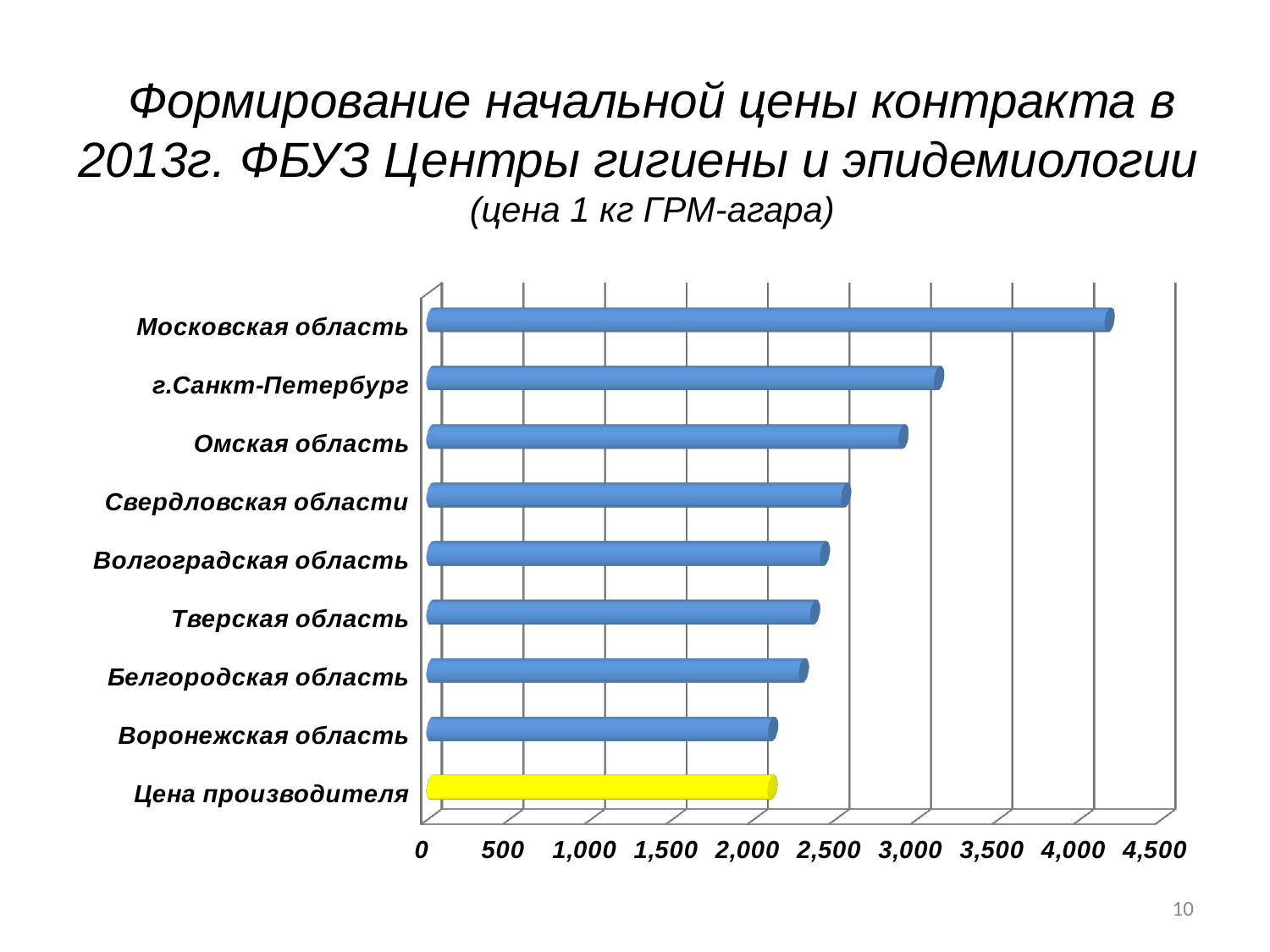
What kind of chart is shown on the slide? bar chart Is the value for Воронежская область greater or less than 2,000? greater Which category is shown with a yellow bar? Цена производителя Is the value for Московская область greater or less than 4,000? greater Is the value for г.Санкт-Петербург greater or less than 3,000? greater Which category has the highest value in the chart? Московская область Which is larger, the value for Московская область or the value for г.Санкт-Петербург? Московская область How many categories are plotted in the chart? 9